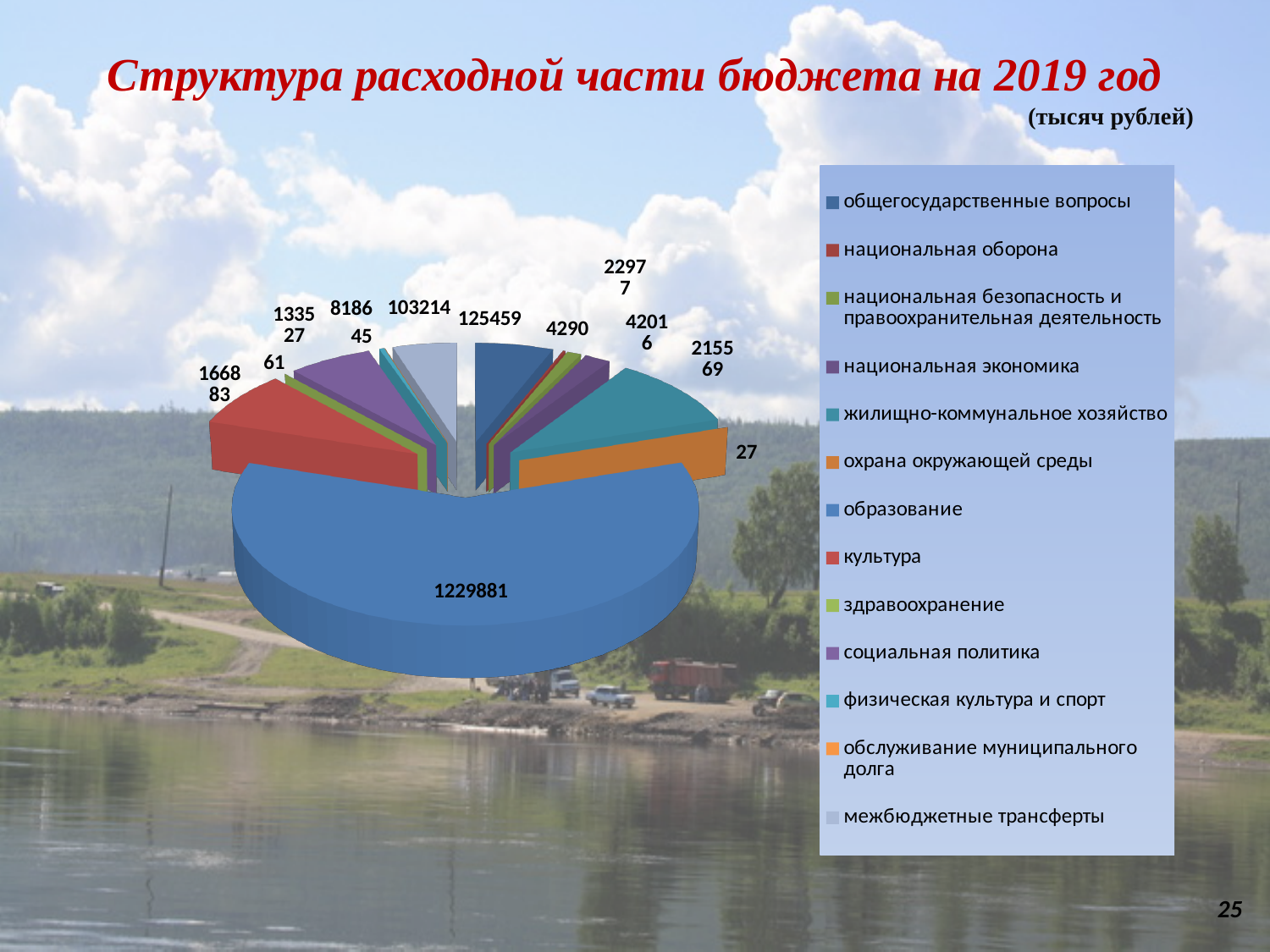
What is the value for образование? 1229881 What is the title of the chart on the slide? Структура расходной части бюджета на 2019 год What is the value for национальная оборона? 4290 What kind of chart is shown on the slide? pie chart In what units are the values on the chart given, according to the slide? тысяч рублей What is the difference between the values for общегосударственные вопросы and межбюджетные трансферты? 22245 Which is larger: образование or жилищно-коммунальное хозяйство? образование Which category has the largest slice of the pie? образование What is the value for общегосударственные вопросы? 125459 Which category has the smallest value on the chart? охрана окружающей среды What is the value for межбюджетные трансферты? 103214 How many categories does the legend of the pie chart list? 13